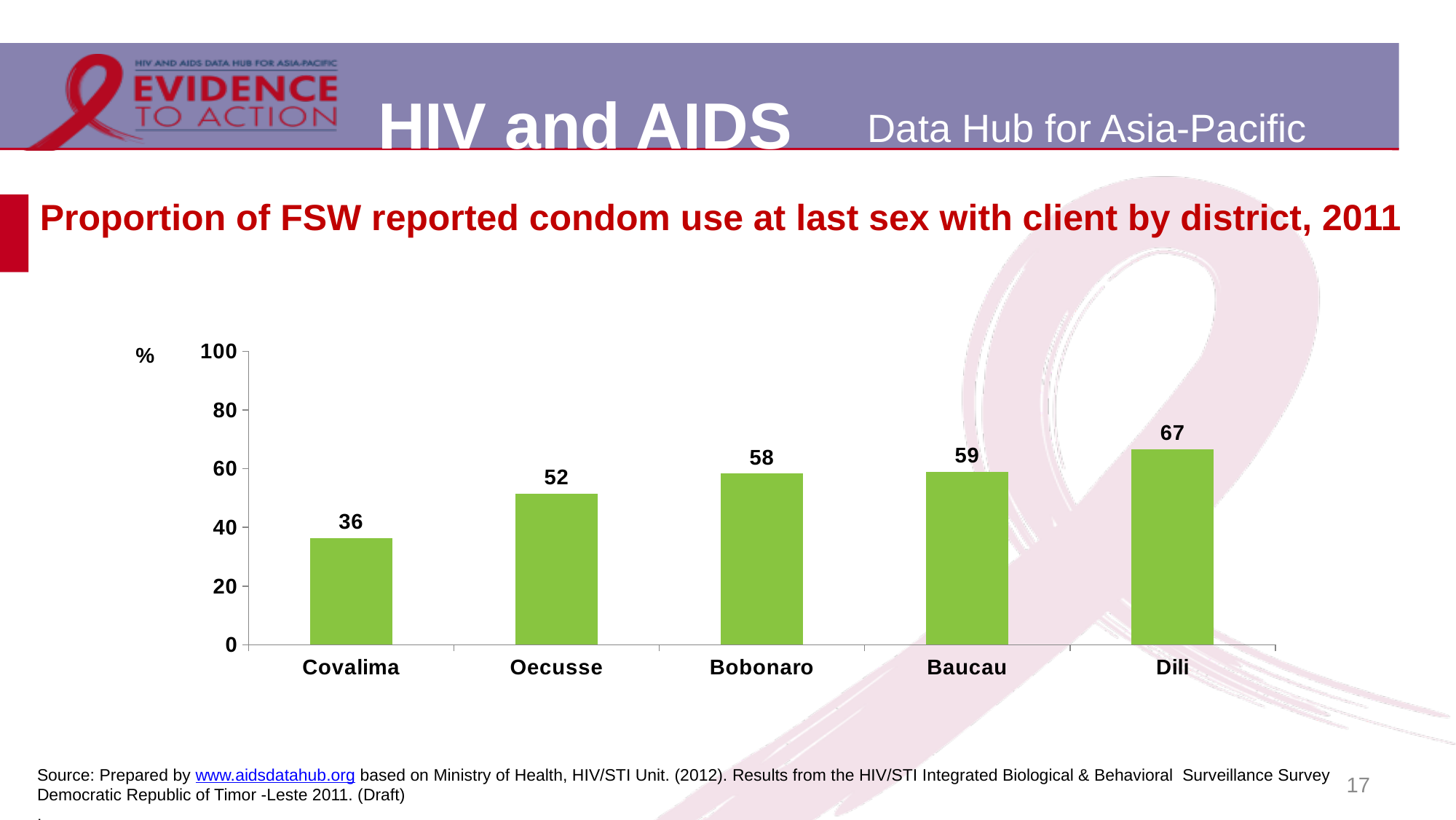
What is the value for Oecusse? 52 What is the value for Dili? 67 Is the value for Covalima greater or less than 40? less What is the difference between the values for Dili and Covalima? 31 Which is larger, the value for Oecusse or the value for Dili? Dili How many districts are shown on the chart? 5 Which district has the highest value? Dili Do the values rise or fall from Covalima to Dili along the x axis? rise What is the difference between the values for Bobonaro and Oecusse? 6 What is the value for Covalima? 36 What kind of chart is shown on the slide? bar chart Which district has the lowest value? Covalima